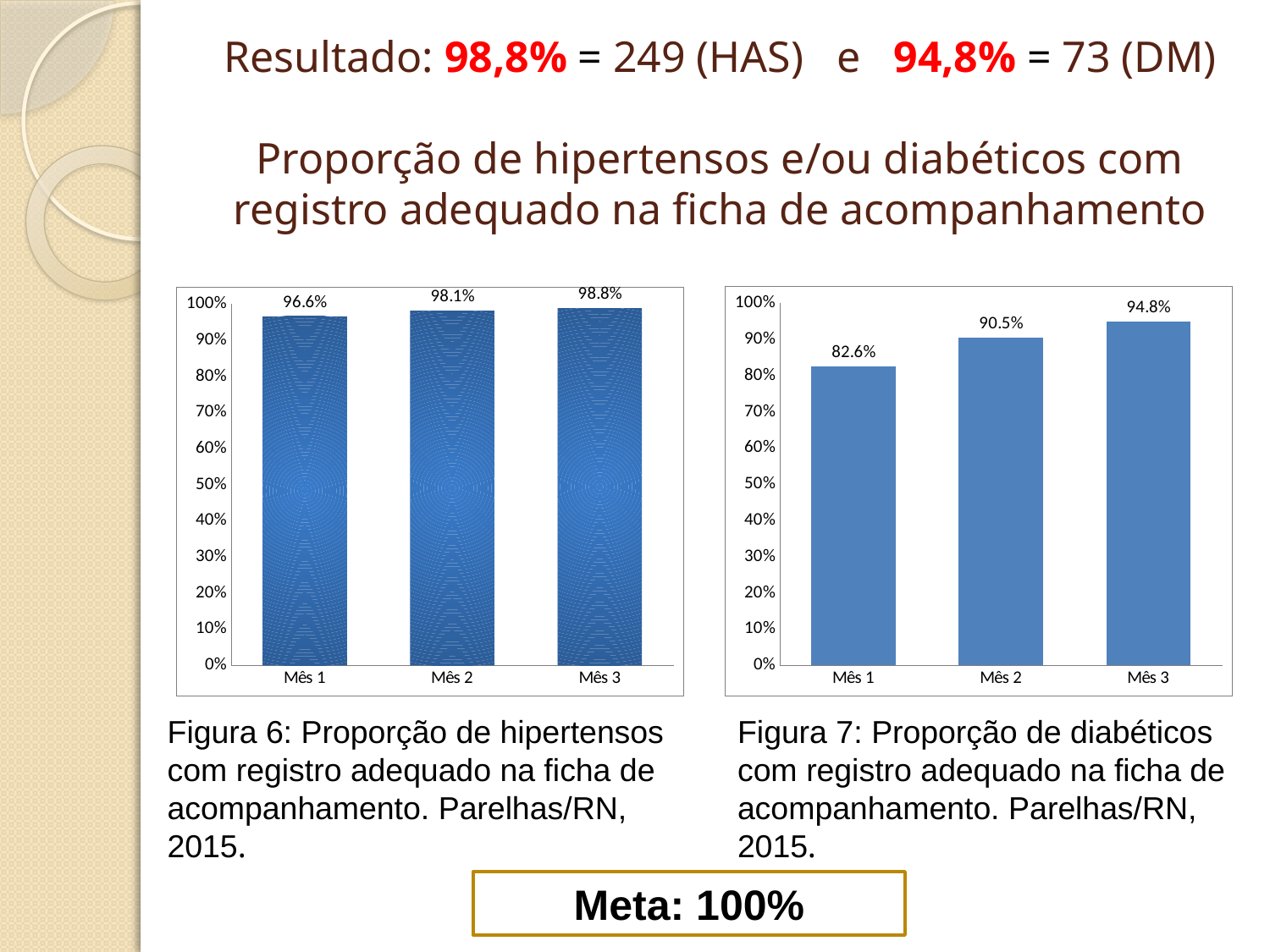
In the right chart (Figura 7, diabéticos), do the values rise or fall from Mês 1 to Mês 3? Rise In the right chart (Figura 7, diabéticos), which month has the lowest value? Mês 1 Which is larger: the Mês 3 value in the left chart (hipertensos) or the Mês 3 value in the right chart (diabéticos)? Left chart (hipertensos), 98.8% In the left chart (Figura 6, hipertensos), what is the value for Mês 1? 96.6% How many bars are plotted in the left chart (Figura 6, hipertensos)? 3 In the right chart (Figura 7, diabéticos), what is the value for Mês 2? 90.5% In the left chart (Figura 6, hipertensos), what is the difference between the values for Mês 2 and Mês 1? 1.5% What kind of chart is the right chart (Figura 7, diabéticos)? Bar chart In the left chart (Figura 6, hipertensos), which month has the highest value? Mês 3 In the right chart (Figura 7, diabéticos), is the value for Mês 1 greater or less than 90%? less In the right chart (Figura 7, diabéticos), what is the difference between the values for Mês 3 and Mês 1? 12.2% What is the target (Meta) shown on the slide for these charts? 100%